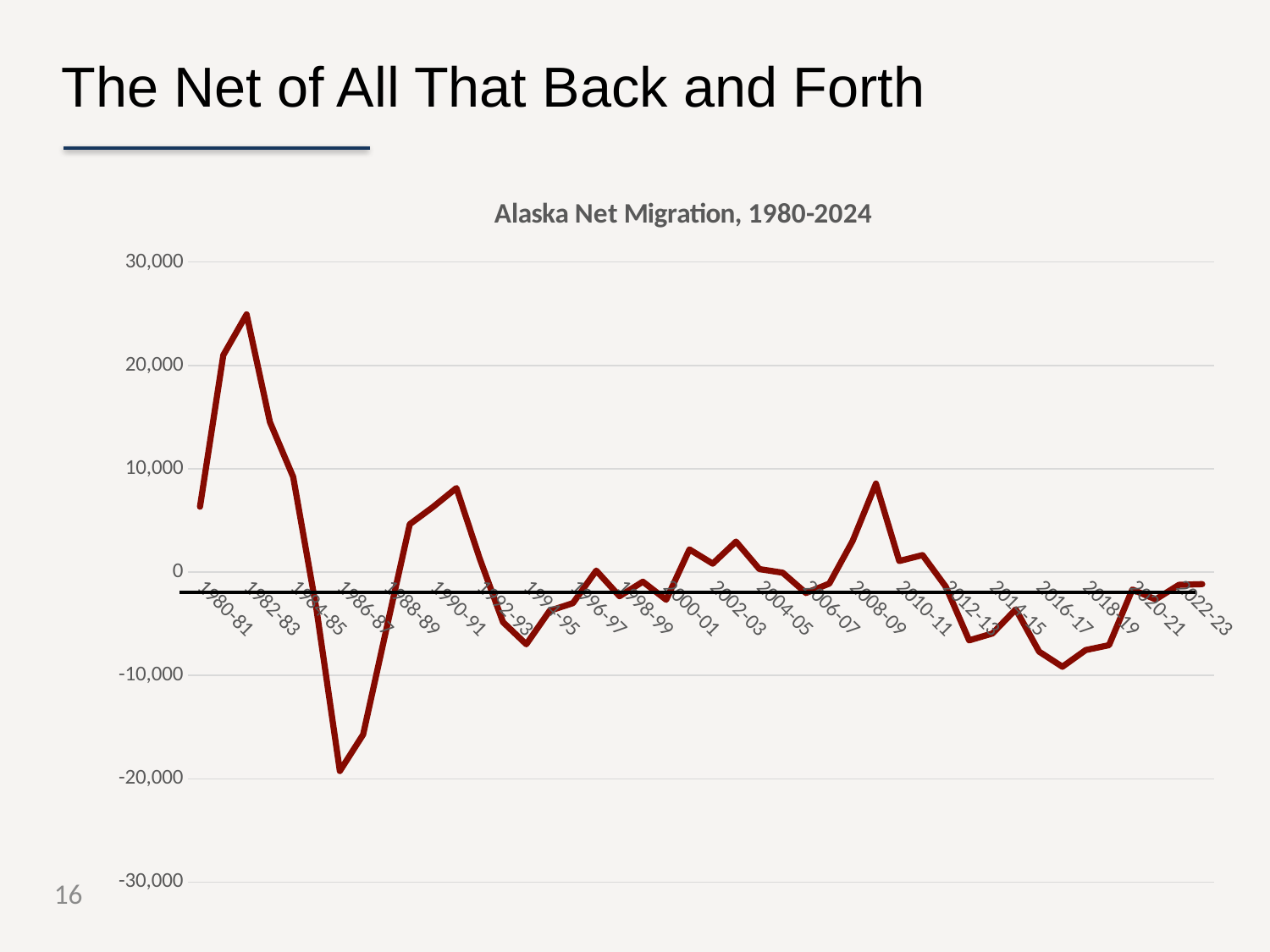
Which is larger, the value for 1982-83 or the value for 2008-09? 1982-83 How many year labels are shown on the x axis? 22 Is the value for 1982-83 greater or less than 20,000? greater What is the title of the chart? Alaska Net Migration, 1980-2024 Which year label on the x axis has the highest net migration value? 1982-83 Does the line rise or fall between 1982-83 and 1986-87? fall What kind of chart is shown on the slide? line chart Is the value for 2016-17 greater or less than 0? less Is the value for 1990-91 greater or less than 10,000? less Which year label on the x axis has the lowest net migration value? 1986-87